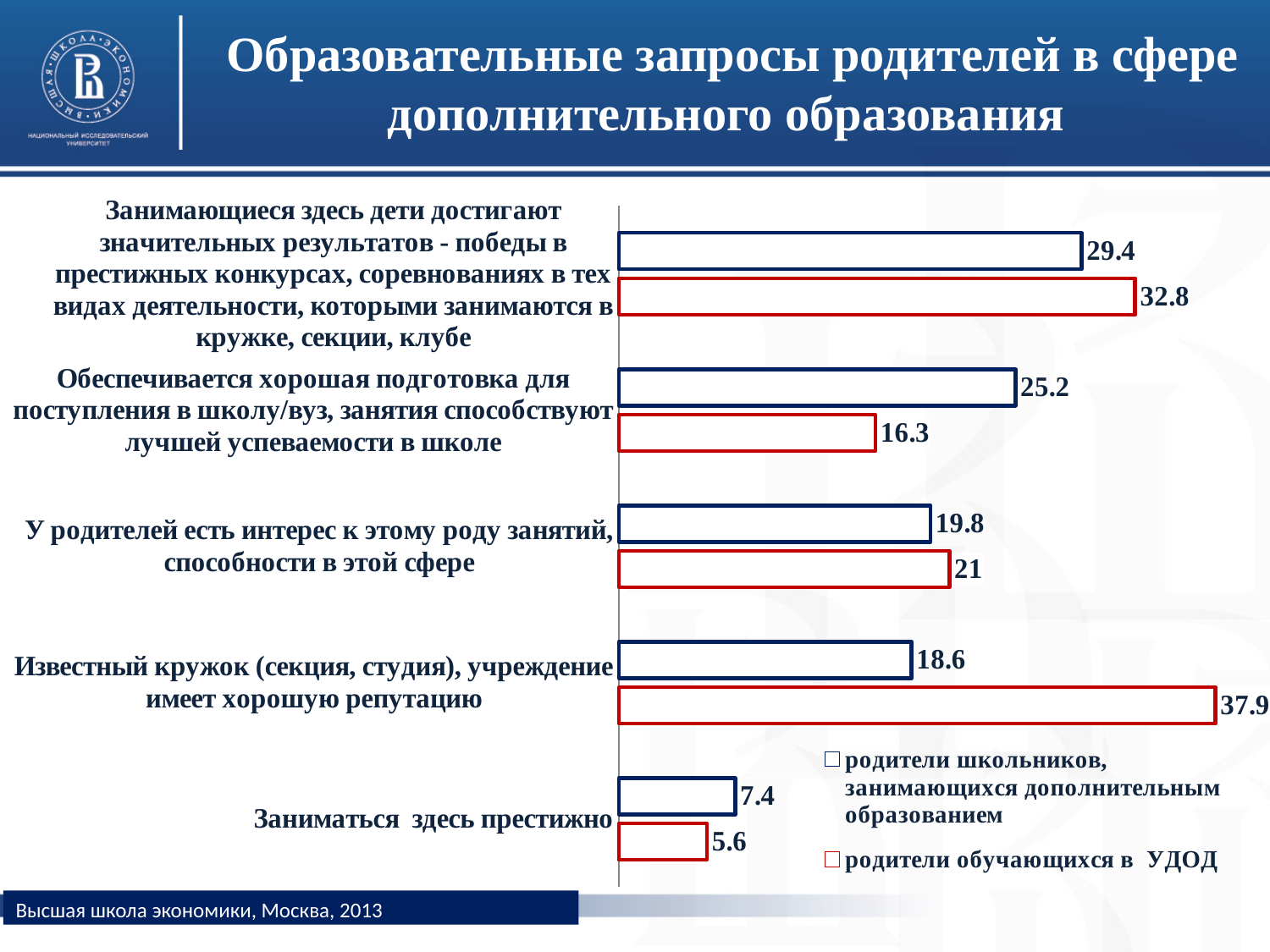
What kind of chart is shown on the slide? bar chart How many series does the legend list? 2 Which category has the highest value for the series "родители обучающихся в УДОД"? Известный кружок (секция, студия), учреждение имеет хорошую репутацию What is the value for "Заниматься здесь престижно" for the series "родители обучающихся в УДОД"? 5.6 What is the value for "Известный кружок (секция, студия), учреждение имеет хорошую репутацию" for the series "родители школьников, занимающихся дополнительным образованием"? 18.6 What is the value for "Обеспечивается хорошая подготовка для поступления в школу/вуз, занятия способствуют лучшей успеваемости в школе" for the series "родители обучающихся в УДОД"? 16.3 For "Обеспечивается хорошая подготовка для поступления в школу/вуз, занятия способствуют лучшей успеваемости в школе", which series has the larger value? родители школьников, занимающихся дополнительным образованием Which category has the lowest value for the series "родители школьников, занимающихся дополнительным образованием"? Заниматься здесь престижно What is the difference between the two series for "Известный кружок (секция, студия), учреждение имеет хорошую репутацию"? 19.3 How many categories are plotted on the chart? 5 Which colour represents the series "родители обучающихся в УДОД"? red What is the difference between the two series for "Заниматься здесь престижно"? 1.8